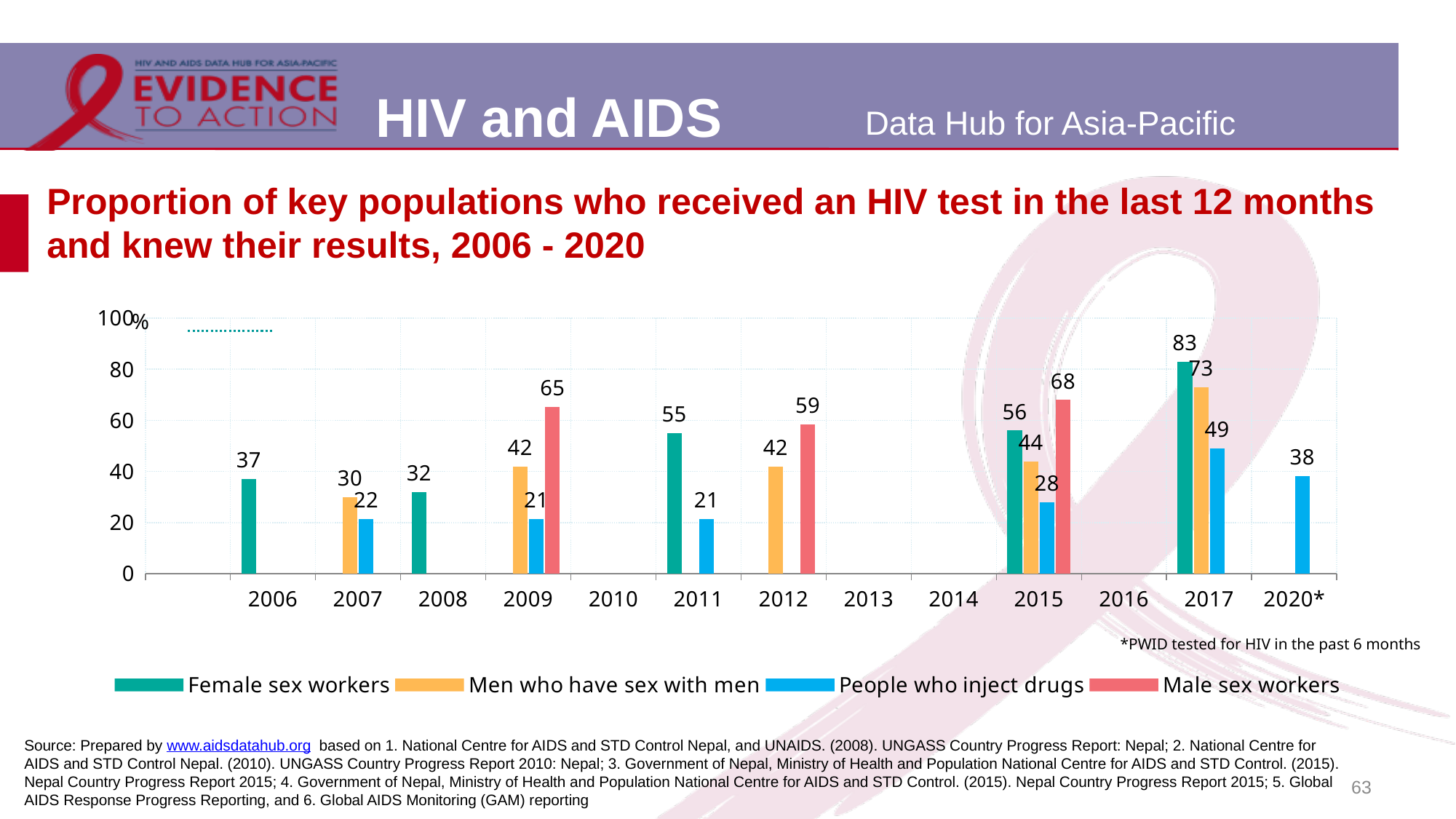
In 2015, which is larger: the value for Male sex workers or for Female sex workers? Male sex workers What is the difference between the Male sex workers and People who inject drugs values in 2015? 40 What is the difference between the Female sex workers and Men who have sex with men values in 2017? 10 In which year is the value for Female sex workers highest? 2017 What is the value for Female sex workers in 2006? 37 What is the value for Men who have sex with men in 2015? 44 How many series does the legend list? 4 What kind of chart is shown on the slide? Bar chart Do the values for Men who have sex with men rise or fall from 2007 to 2017? Rise What is the value for People who inject drugs in 2020*? 38 In which year is the value for Men who have sex with men lowest? 2007 What is the value for Male sex workers in 2009? 65